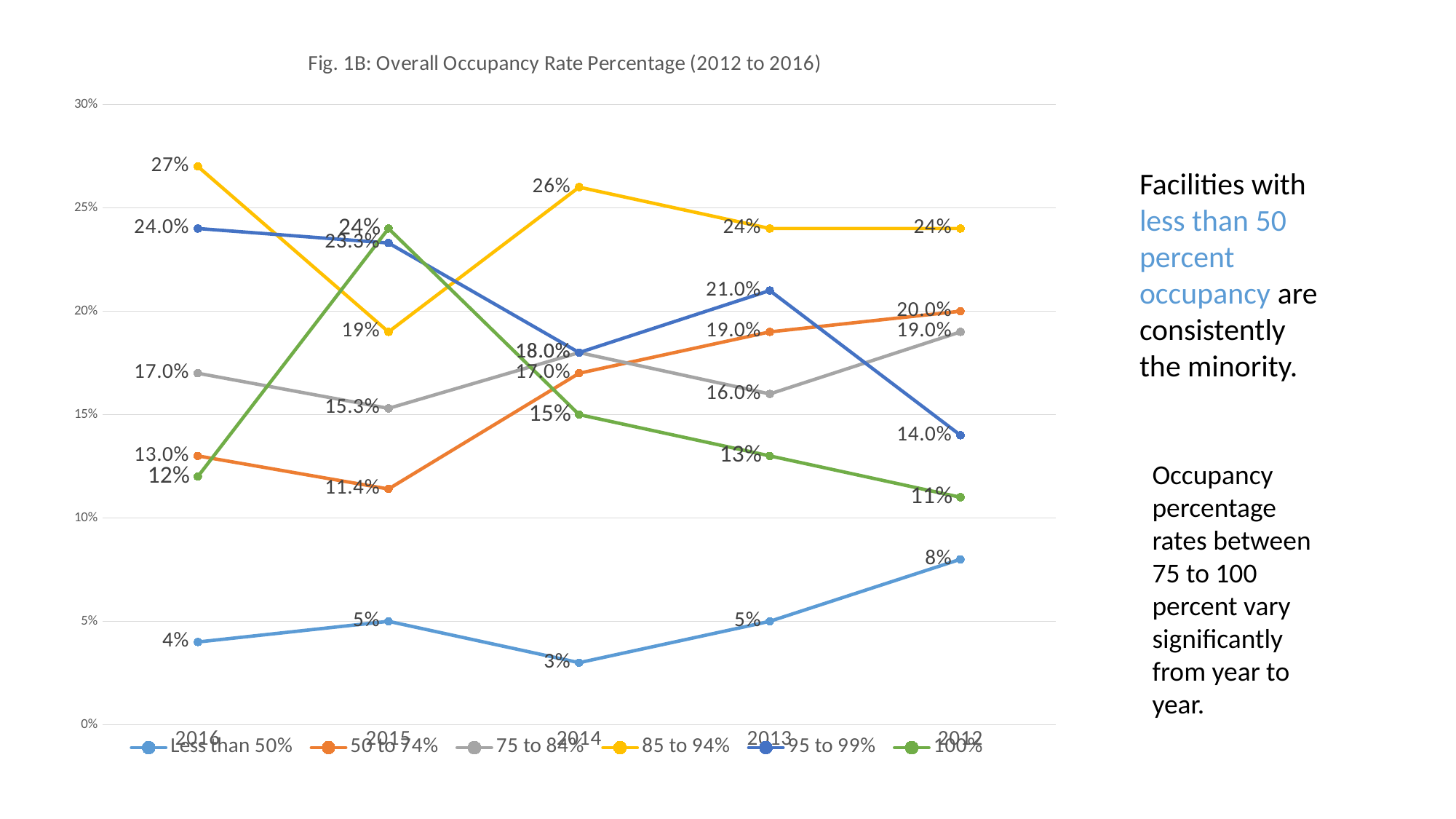
What type of chart is shown on the slide? Line chart In which year is the 85 to 94% series at its highest? 2016 What is the value for the 95 to 99% series in 2012? 14.0% What is the title of the chart? Fig. 1B: Overall Occupancy Rate Percentage (2012 to 2016) How many series does the legend list? 6 What is the value for the 100% series in 2015? 24% What is the value for the 85 to 94% series in 2016? 27% In which year is the Less than 50% series at its lowest? 2014 In 2013, which is larger: the 95 to 99% series or the 50 to 74% series? 95 to 99% How many years are plotted along the x axis? 5 What is the difference between the 50 to 74% series values in 2012 and 2016? 7.0 percentage points What is the value for the Less than 50% series in 2012? 8%